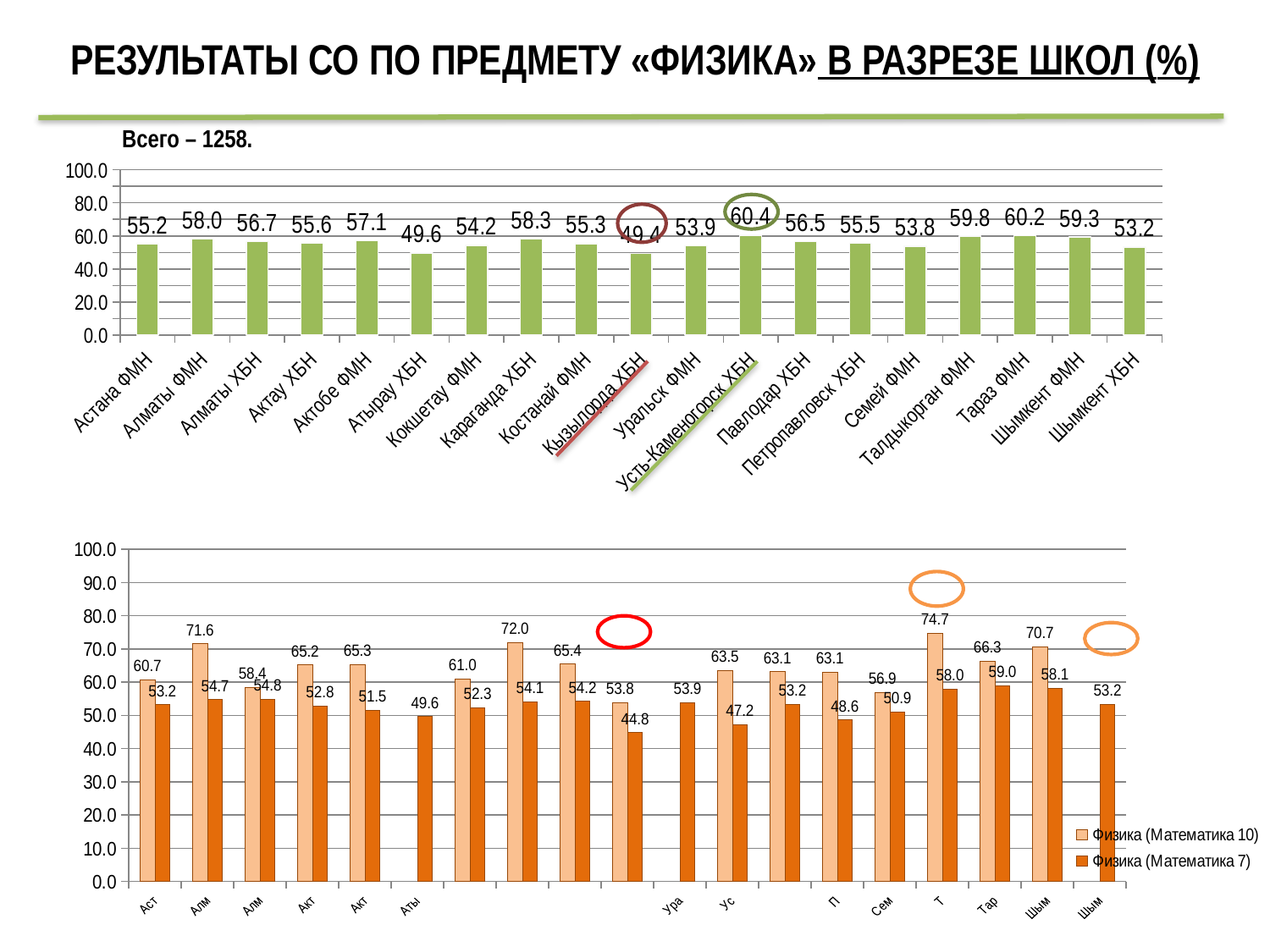
How many series does the legend of the bottom chart list? 2 In the top chart, which school has the lowest value? Кызылорда ХБН In the bottom chart, what is the value of Физика (Математика 10) for the category Аст? 60.7 What kind of chart is the top chart? Bar chart In the top chart, what is the value for Астана ФМН? 55.2 In the bottom chart, what is the highest value in the Физика (Математика 10) series? 74.7 In the top chart, which school has the highest value? Усть-Каменогорск ХБН What total is stated above the top chart? Всего – 1258. In the top chart, what is the value for Усть-Каменогорск ХБН? 60.4 In the top chart, what is the difference between the values for Тараз ФМН and Семей ФМН? 6.4 In the top chart, which is larger: the value for Караганда ХБН or the value for Кокшетау ФМН? Караганда ХБН How many schools (bars) are shown in the top chart? 19